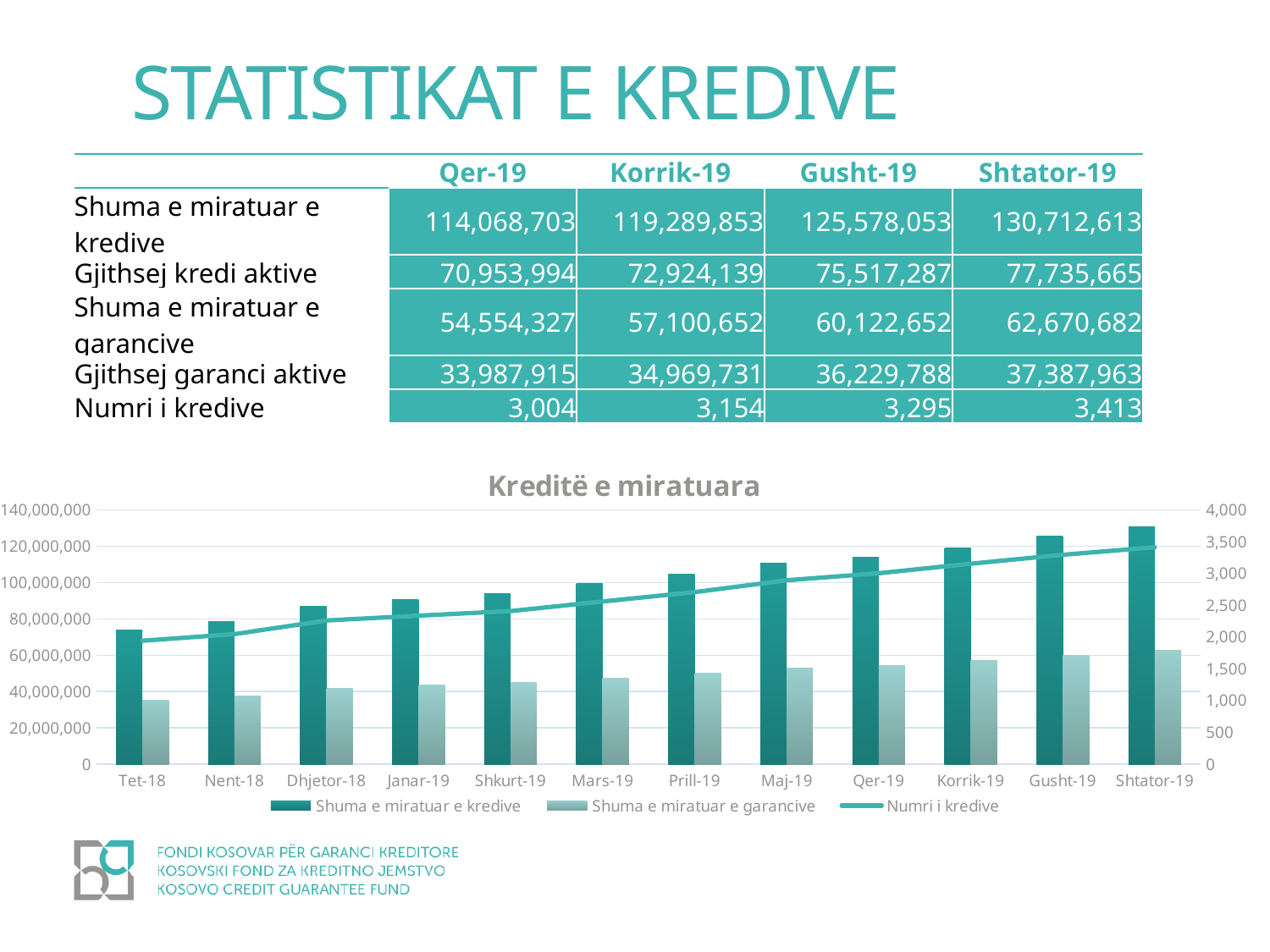
In the "Kreditë e miratuara" chart, is the value of Shuma e miratuar e garancive for Maj-19 greater or less than 60,000,000? less How many series does the legend of the "Kreditë e miratuara" chart list? 3 In the "Kreditë e miratuara" chart, which month has the highest Shuma e miratuar e kredive? Shtator-19 In the "Kreditë e miratuara" chart, what is the difference between Shuma e miratuar e kredive for Shtator-19 and for Qer-19? 16,643,910 In the "Kreditë e miratuara" chart, what is the value of Shuma e miratuar e garancive for Qer-19? 54,554,327 In the "Kreditë e miratuara" chart, what is the value of Numri i kredive for Gusht-19? 3,295 In the "Kreditë e miratuara" chart, which month has the lowest Shuma e miratuar e garancive? Tet-18 What is the title of the chart on the slide? Kreditë e miratuara What kind of chart is "Kreditë e miratuara"? bar chart with a line In the "Kreditë e miratuara" chart, does Shuma e miratuar e kredive rise or fall from Tet-18 to Shtator-19? rise How many months are shown on the x axis of the "Kreditë e miratuara" chart? 12 In the "Kreditë e miratuara" chart, what is the value of Shuma e miratuar e kredive for Shtator-19? 130,712,613